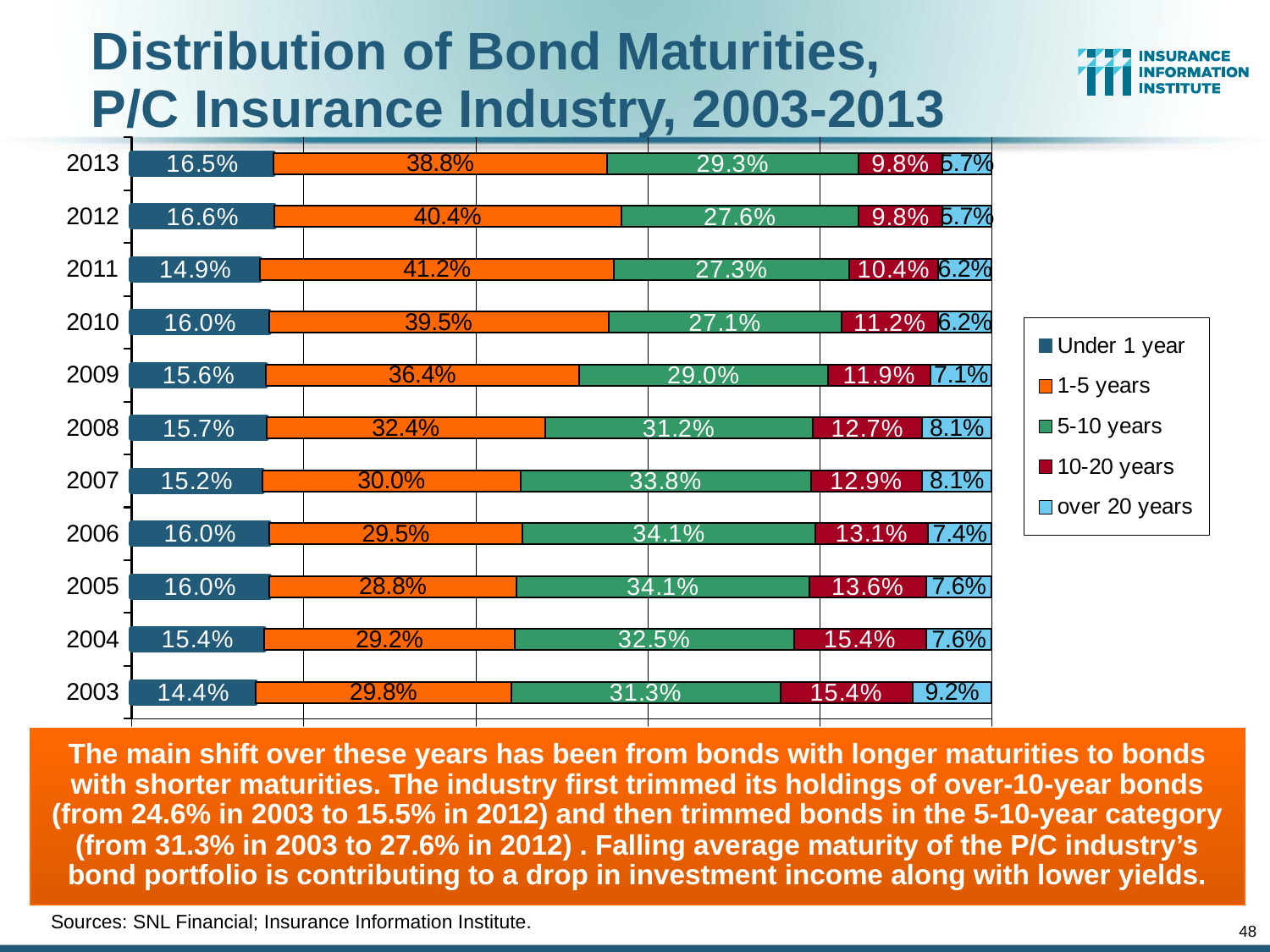
Which year had the lowest share of bonds in the 1-5 years category? 2005 How many series does the legend list? 5 What was the Under 1 year share in 2009? 15.6% Which year had the highest share of bonds in the 1-5 years category? 2011 What share of bonds had maturities of 1-5 years in 2011? 41.2% Did the 10-20 years share rise or fall from 2003 to 2013? fall What share of bonds had maturities of 5-10 years in 2003? 31.3% What kind of chart is shown on the slide? bar chart Which year had the highest share of bonds with maturities over 20 years? 2003 In 2007, which was larger: the 1-5 years share or the 5-10 years share? 5-10 years How many years are shown on the chart? 11 By how many percentage points did the 10-20 years share fall from 2003 to 2013? 5.6 percentage points